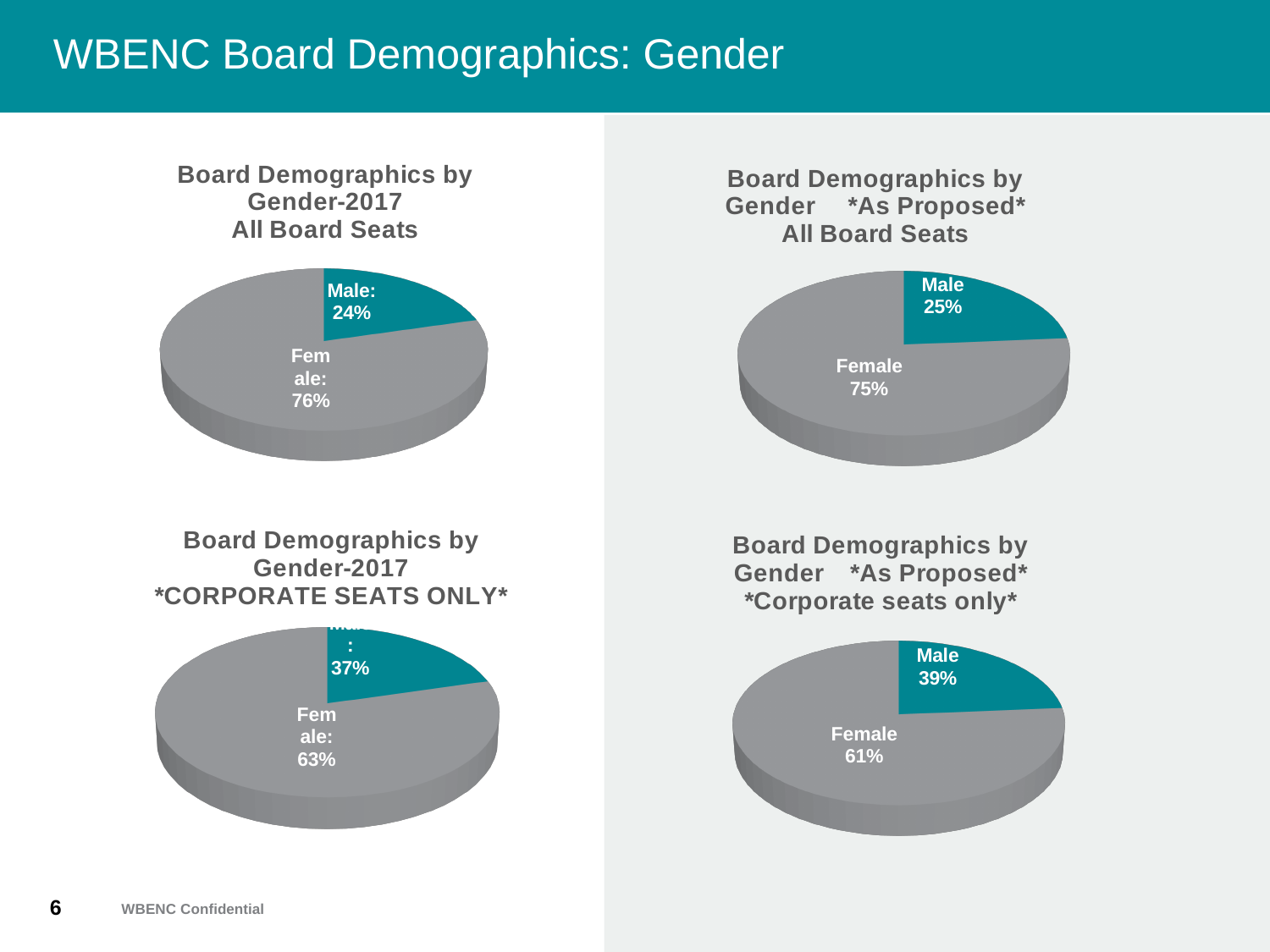
In the bottom-left chart (Board Demographics by Gender-2017, Corporate Seats Only), what percentage is Female? 63% In the top-right chart (Board Demographics by Gender, As Proposed, All Board Seats), what percentage is Female? 75% In the top-right chart (Board Demographics by Gender, As Proposed, All Board Seats), what percentage is Male? 25% What kind of chart is used for the top-right chart (Board Demographics by Gender, As Proposed, All Board Seats)? Pie chart In the top-left chart (Board Demographics by Gender-2017, All Board Seats), what percentage of board seats is Male? 24% In the top-left chart (Board Demographics by Gender-2017, All Board Seats), what percentage of board seats is Female? 76% How many charts are shown on the slide? 4 In the bottom-right chart (Board Demographics by Gender, As Proposed, Corporate seats only), what percentage is Female? 61% In the bottom-right chart (Board Demographics by Gender, As Proposed, Corporate seats only), what percentage is Male? 39% In the bottom-right chart (Board Demographics by Gender, As Proposed, Corporate seats only), what is the difference between the Female and Male percentages? 22% In the top-left chart (Board Demographics by Gender-2017, All Board Seats), which gender has the larger share? Female In the bottom-left chart (Board Demographics by Gender-2017, Corporate Seats Only), what percentage is shown for the teal slice? 37%